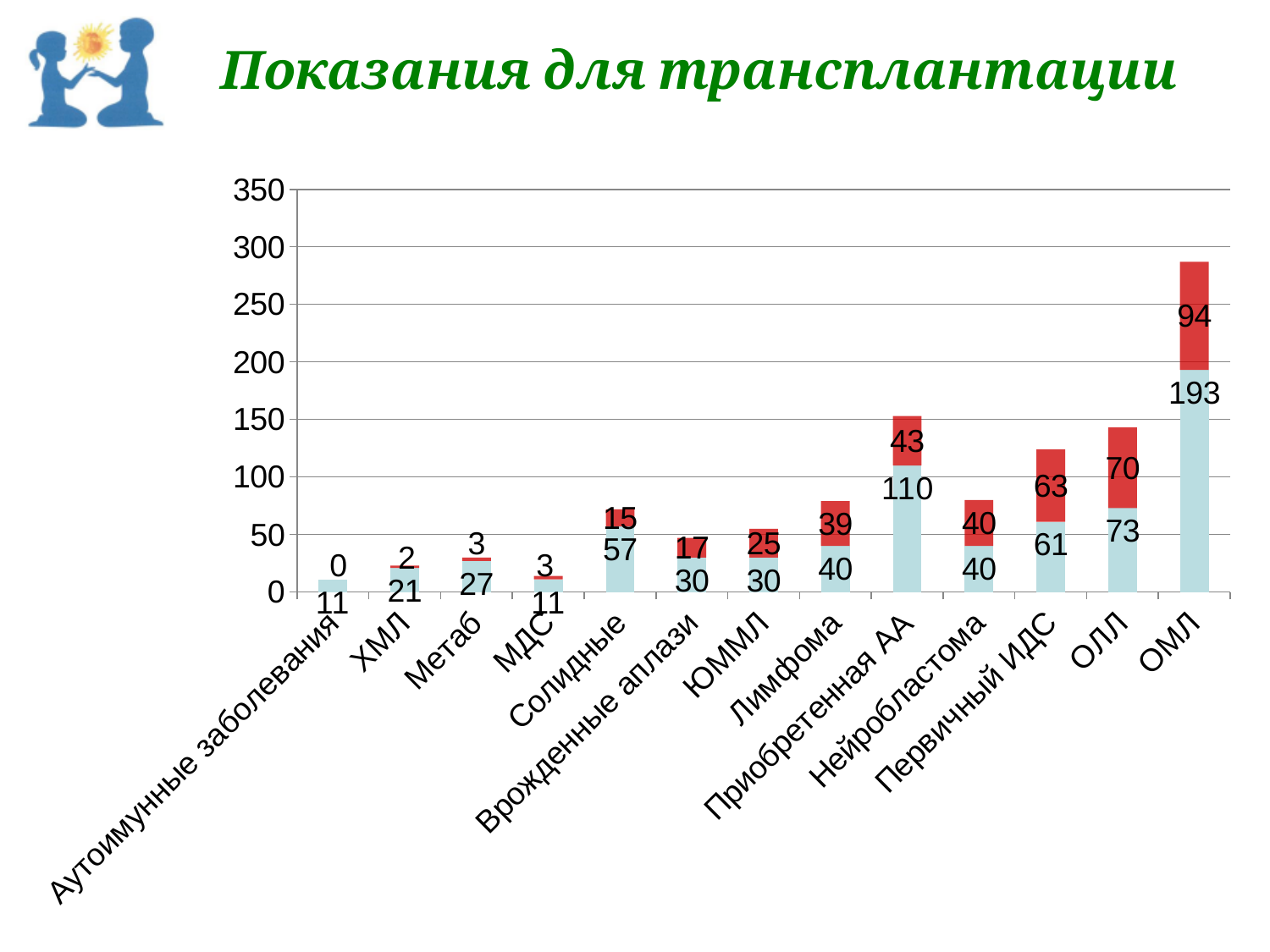
Which category has the highest total bar? ОМЛ What is the value of the light blue segment for Первичный ИДС? 61 What is the value of the light blue segment for ОМЛ? 193 What is the value of the red segment for Приобретенная АА? 43 What kind of chart is shown on the slide? bar chart Which has the larger total bar, Первичный ИДС or Приобретенная АА? Приобретенная АА Which category has the lowest total bar? Аутоимунные заболевания What is the title of the slide? Показания для трансплантации What is the total of the stacked bar for ОЛЛ? 143 What is the difference between the light blue values for ОМЛ and Приобретенная АА? 83 What is the total of the stacked bar for ОМЛ? 287 How many categories are shown along the x axis of the chart? 13